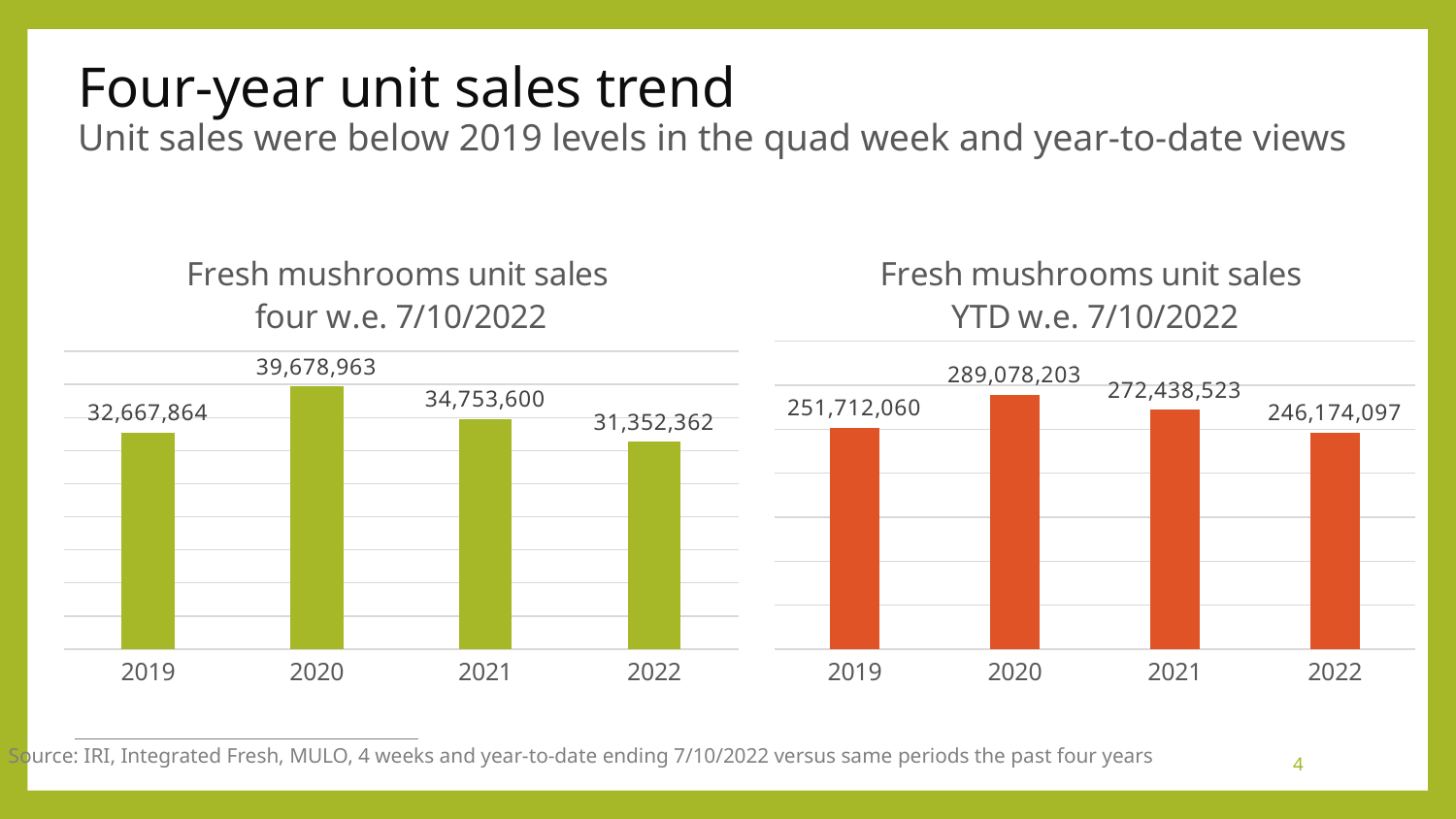
How many years are shown on the x axis of the 'Fresh mushrooms unit sales four w.e. 7/10/2022' chart? 4 In the 'Fresh mushrooms unit sales four w.e. 7/10/2022' chart, which year has the lowest value? 2022 In the 'Fresh mushrooms unit sales four w.e. 7/10/2022' chart, do the values rise or fall from 2020 to 2022? Fall In the 'Fresh mushrooms unit sales four w.e. 7/10/2022' chart, what is the value for 2020? 39,678,963 In the 'Fresh mushrooms unit sales YTD w.e. 7/10/2022' chart, which year has the highest value? 2020 In the 'Fresh mushrooms unit sales YTD w.e. 7/10/2022' chart, what is the difference between the 2020 and 2022 values? 42,904,106 In the 'Fresh mushrooms unit sales four w.e. 7/10/2022' chart, what is the difference between the 2020 and 2019 values? 7,011,099 In the 'Fresh mushrooms unit sales YTD w.e. 7/10/2022' chart, what is the value for 2022? 246,174,097 What type of chart is the 'Fresh mushrooms unit sales YTD w.e. 7/10/2022' chart? Bar chart In the 'Fresh mushrooms unit sales four w.e. 7/10/2022' chart, what is the value for 2021? 34,753,600 In the 'Fresh mushrooms unit sales YTD w.e. 7/10/2022' chart, which is larger, the value for 2019 or the value for 2021? 2021 What colour are the bars in the 'Fresh mushrooms unit sales YTD w.e. 7/10/2022' chart? Orange